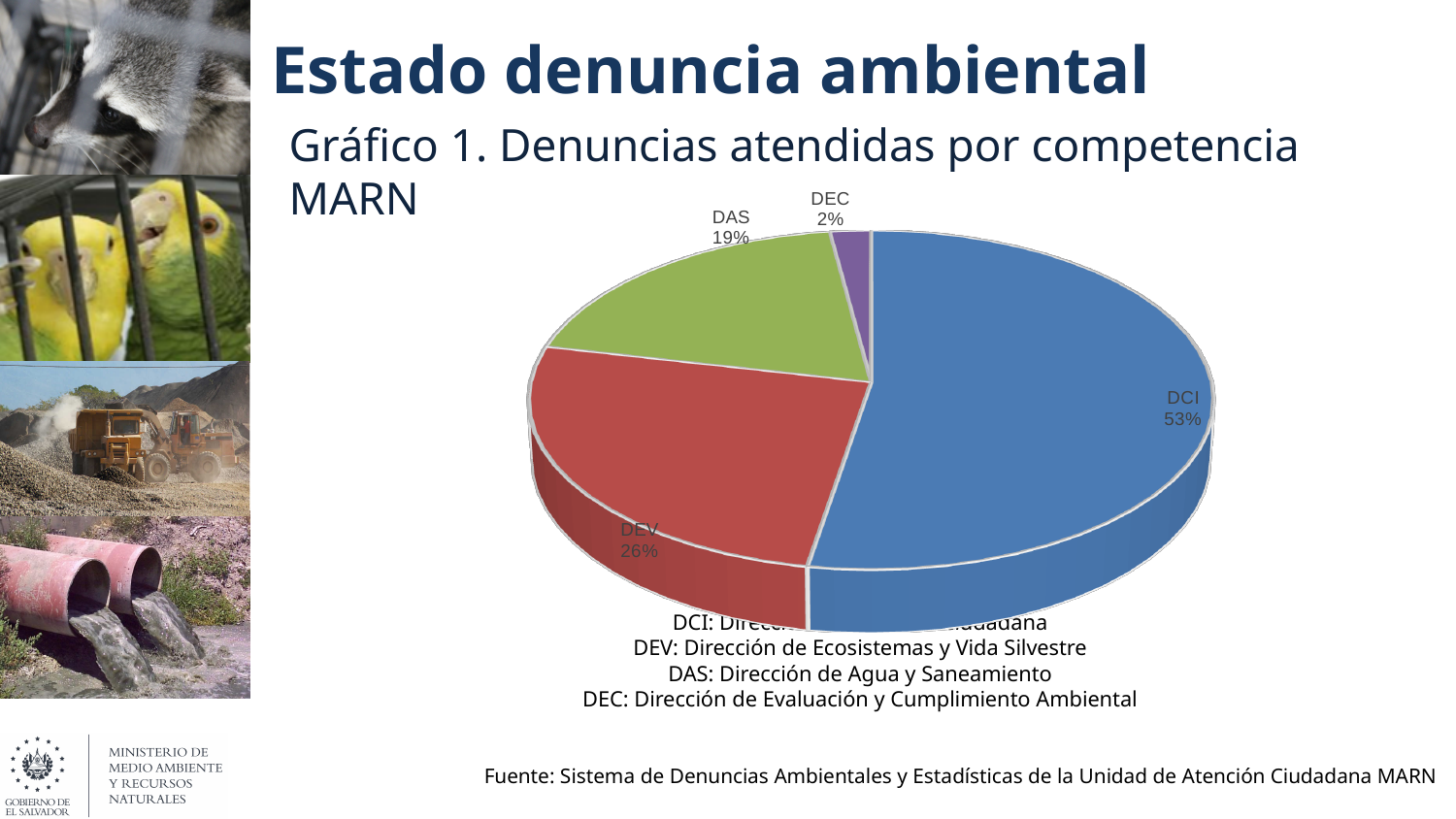
What type of chart is shown on the slide? Pie chart Which category has the smallest slice of the pie? DEC Which slice is larger, DAS or DEV? DEV What is the title of the chart? Gráfico 1. Denuncias atendidas por competencia MARN How many slices does the pie chart have? 4 Which category has the largest slice of the pie? DCI What is the difference in percentage points between the DEV and DAS slices? 7 What share of the pie does DAS represent? 19% What share of the pie does DEV represent? 26% What share of the pie does DEC represent? 2% What is the difference in percentage points between the DCI and DEV slices? 27